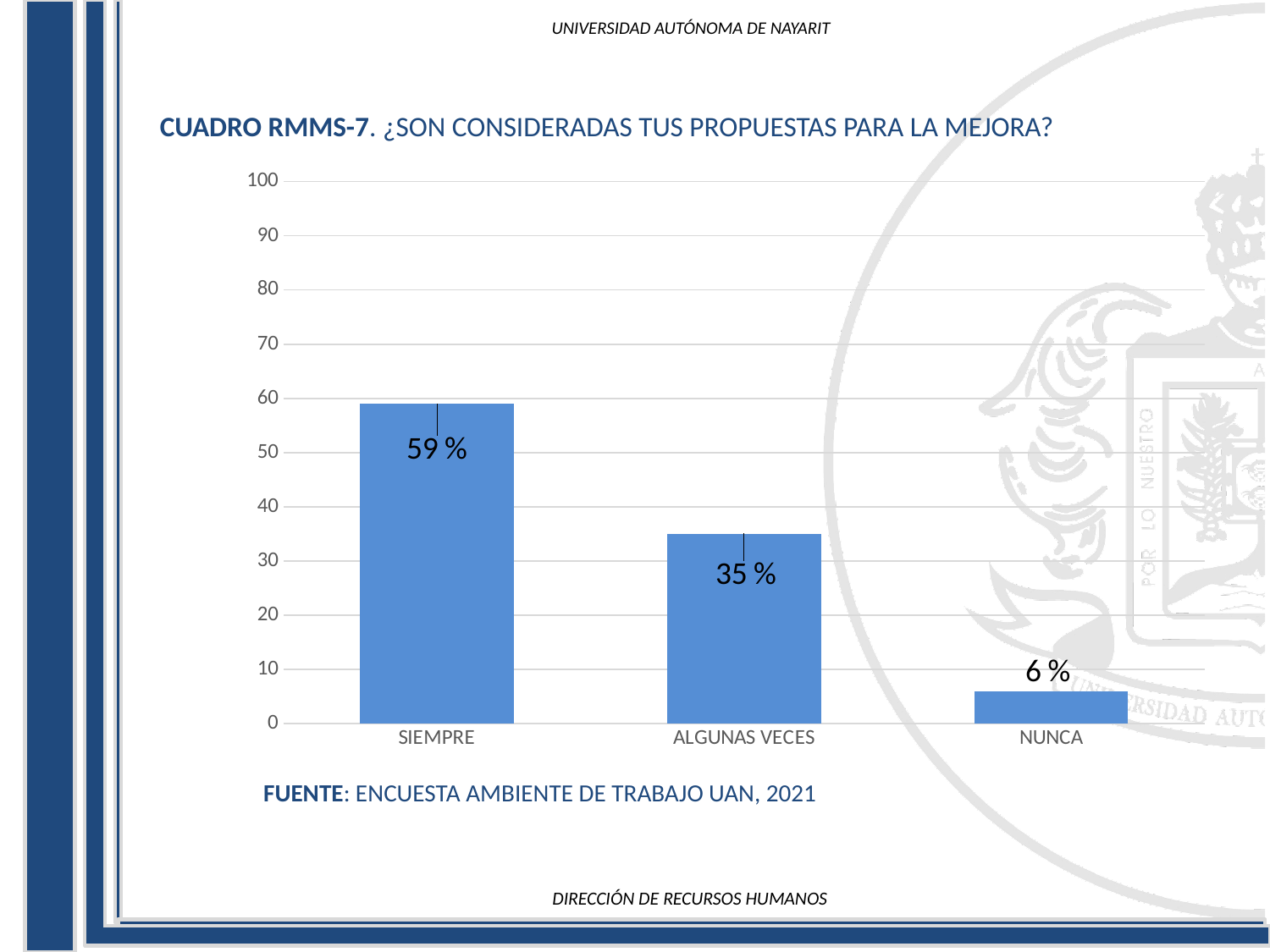
What is the value for SIEMPRE? 59 % Is the value for SIEMPRE greater or less than 50? greater What is the difference between the values for SIEMPRE and ALGUNAS VECES? 24 % What is the value for ALGUNAS VECES? 35 % What is the source cited below the chart? ENCUESTA AMBIENTE DE TRABAJO UAN, 2021 What is the value for NUNCA? 6 % How many categories are shown on the x axis? 3 Which is larger, the value for ALGUNAS VECES or the value for NUNCA? ALGUNAS VECES What is the difference between the values for ALGUNAS VECES and NUNCA? 29 % What kind of chart is shown on the slide? bar chart Which category has the lowest value? NUNCA Which category has the highest value? SIEMPRE